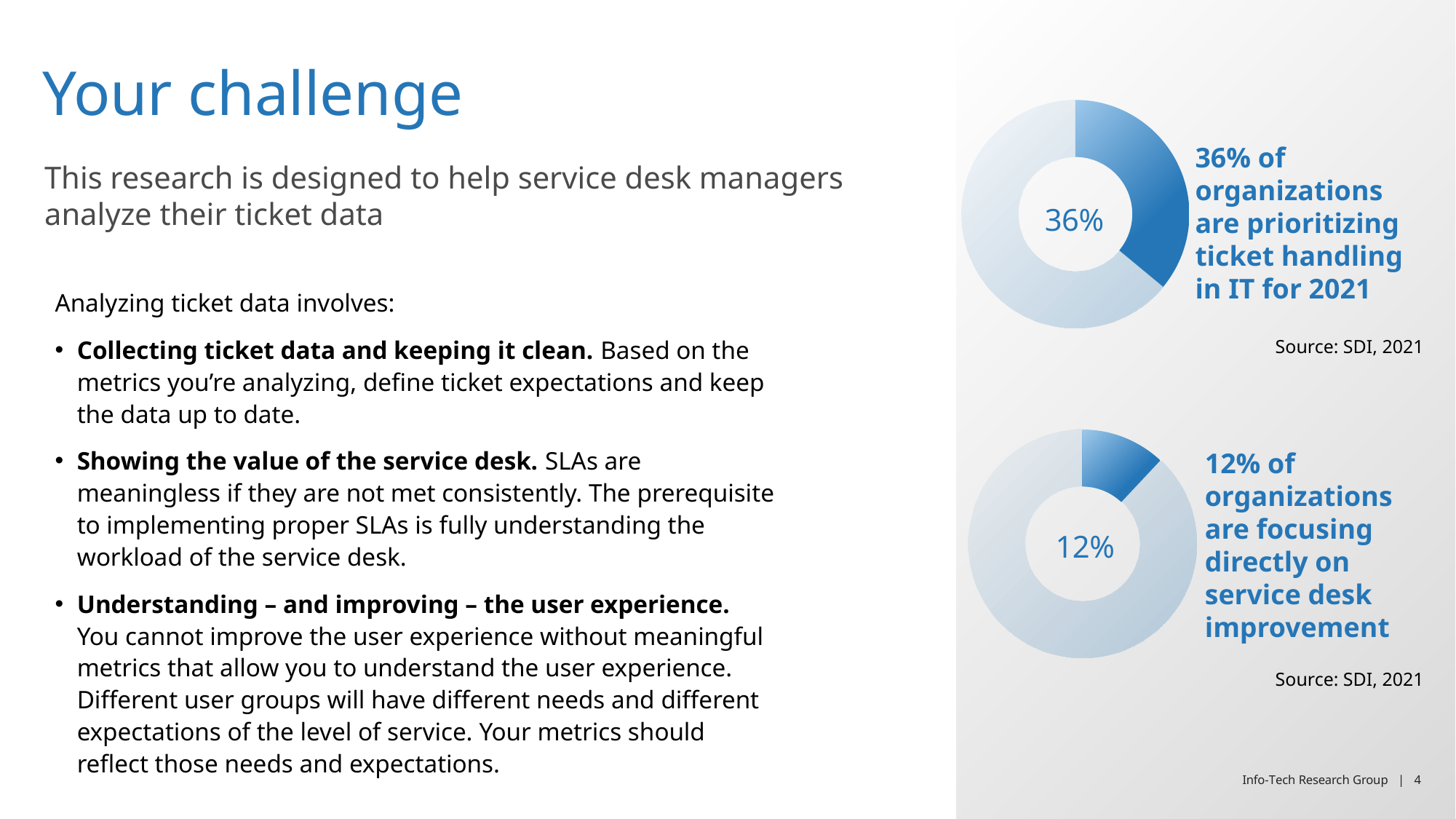
What value is shown in the centre of the top donut chart on the right of the slide? 36% What value is shown in the centre of the bottom donut chart on the right of the slide? 12% By how many percentage points does the top chart's value (36%) exceed the bottom chart's value (12%)? 24 percentage points Which chart shows the larger highlighted share: the top chart (prioritizing ticket handling) or the bottom chart (focusing on service desk improvement)? The top chart How many donut charts are shown on the slide? 2 In the top donut chart, what share of organizations are prioritizing ticket handling in IT for 2021? 36% What does the text next to the top donut chart say the 36% represents? Organizations prioritizing ticket handling in IT for 2021 What kind of chart is used to show the 36% figure on the slide? Donut (pie) chart In the bottom donut chart, what share of organizations are focusing directly on service desk improvement? 12% What source is cited beneath each donut chart on the slide? SDI, 2021 Is the highlighted share in the bottom donut chart greater or less than 25%? less Is the highlighted share in the top donut chart greater or less than 50%? less